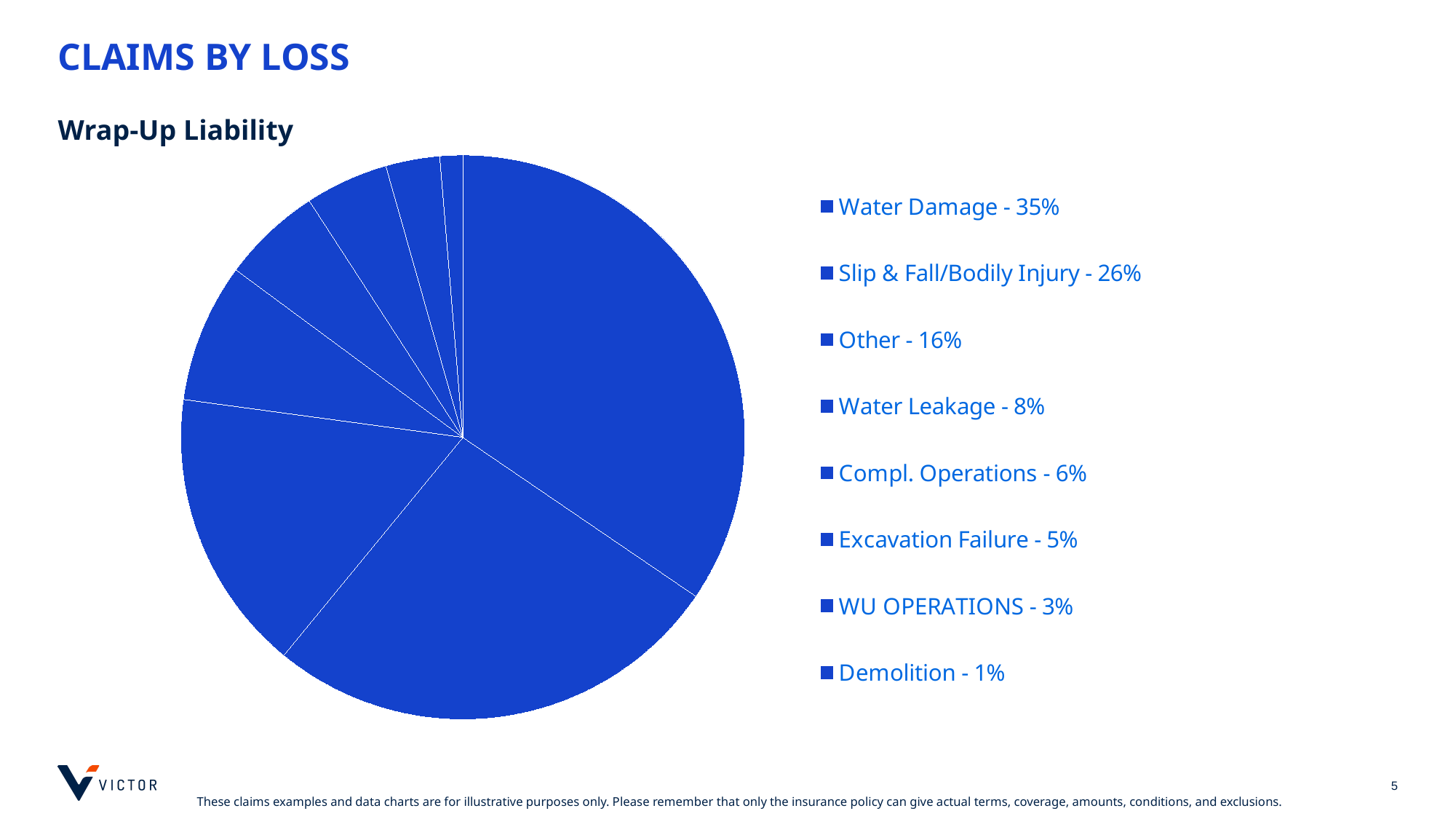
Which loss category has the smallest share of claims? Demolition What percentage of claims is Slip & Fall/Bodily Injury? 26% Which loss category has the largest share of claims? Water Damage What kind of chart is shown on the slide? Pie chart How many percentage points larger is Water Damage than Slip & Fall/Bodily Injury? 9 What share of claims does the Other category account for? 16% What share of claims is attributed to Water Damage? 35% What is the title of the slide containing the chart? CLAIMS BY LOSS Which has a larger share of claims, Other or Water Leakage? Other What percentage of claims is Excavation Failure? 5% What is the difference in percentage points between Water Leakage and Compl. Operations? 2 How many loss categories are shown in the pie chart? 8